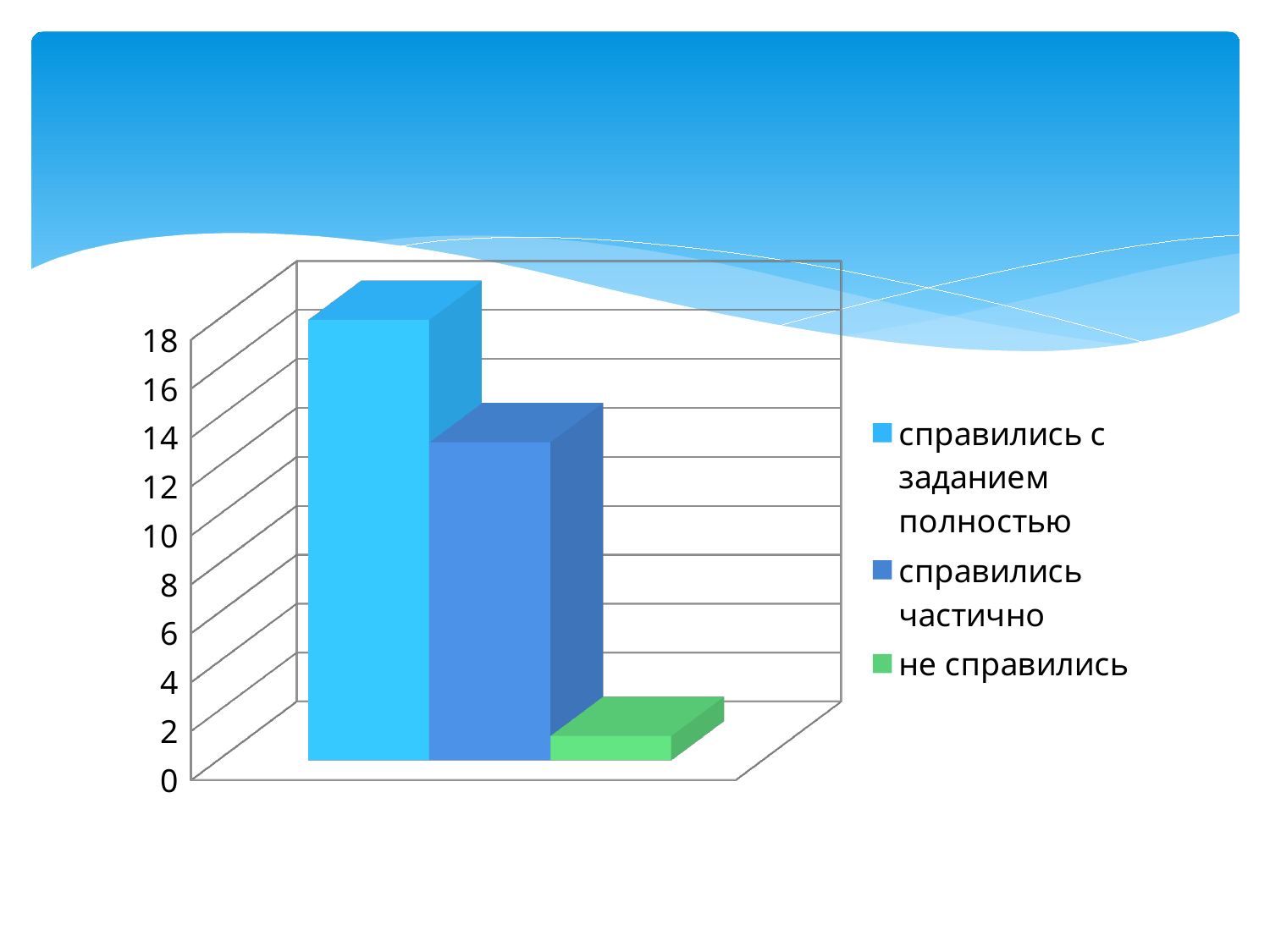
Which is larger, the bar for "справились с заданием полностью" or the bar for "справились частично"? справились с заданием полностью How many series does the legend list? 3 Is the value for "справились частично" greater or less than 8? greater Which series has the lowest bar? не справились Is the value for "не справились" greater or less than 4? less Is the value for "справились с заданием полностью" greater or less than 14? greater What is the highest tick value shown on the vertical axis? 18 What colour is used for the "не справились" series? green Which is larger, the bar for "справились частично" or the bar for "не справились"? справились частично How many bars are plotted in the chart? 3 What kind of chart is shown on the slide? bar chart Which series has the highest bar? справились с заданием полностью